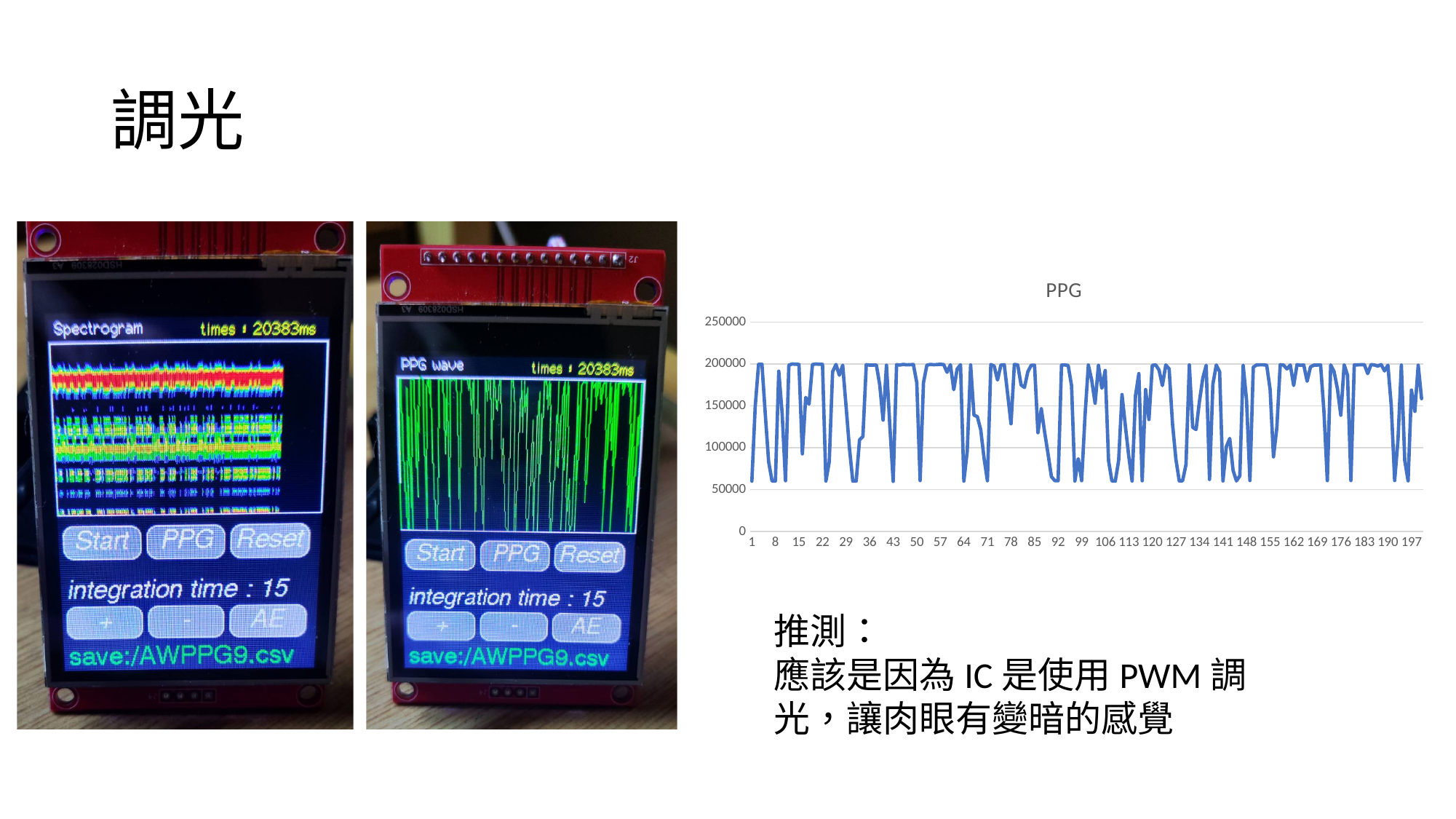
What kind of chart is shown on the slide? line chart Does the PPG line show a steady rise, a steady fall, or repeated oscillation along the x axis? repeated oscillation What is the last label shown on the chart's x axis? 197 How many labels are printed along the chart's x axis? 29 What is the highest value shown on the chart's y axis? 250000 Is the lowest value reached by the PPG line greater or less than 100000? less What is the title of the chart? PPG Does the PPG line ever reach the 250000 gridline? no Is the value of the PPG line at x = 1 greater or less than 150000? less